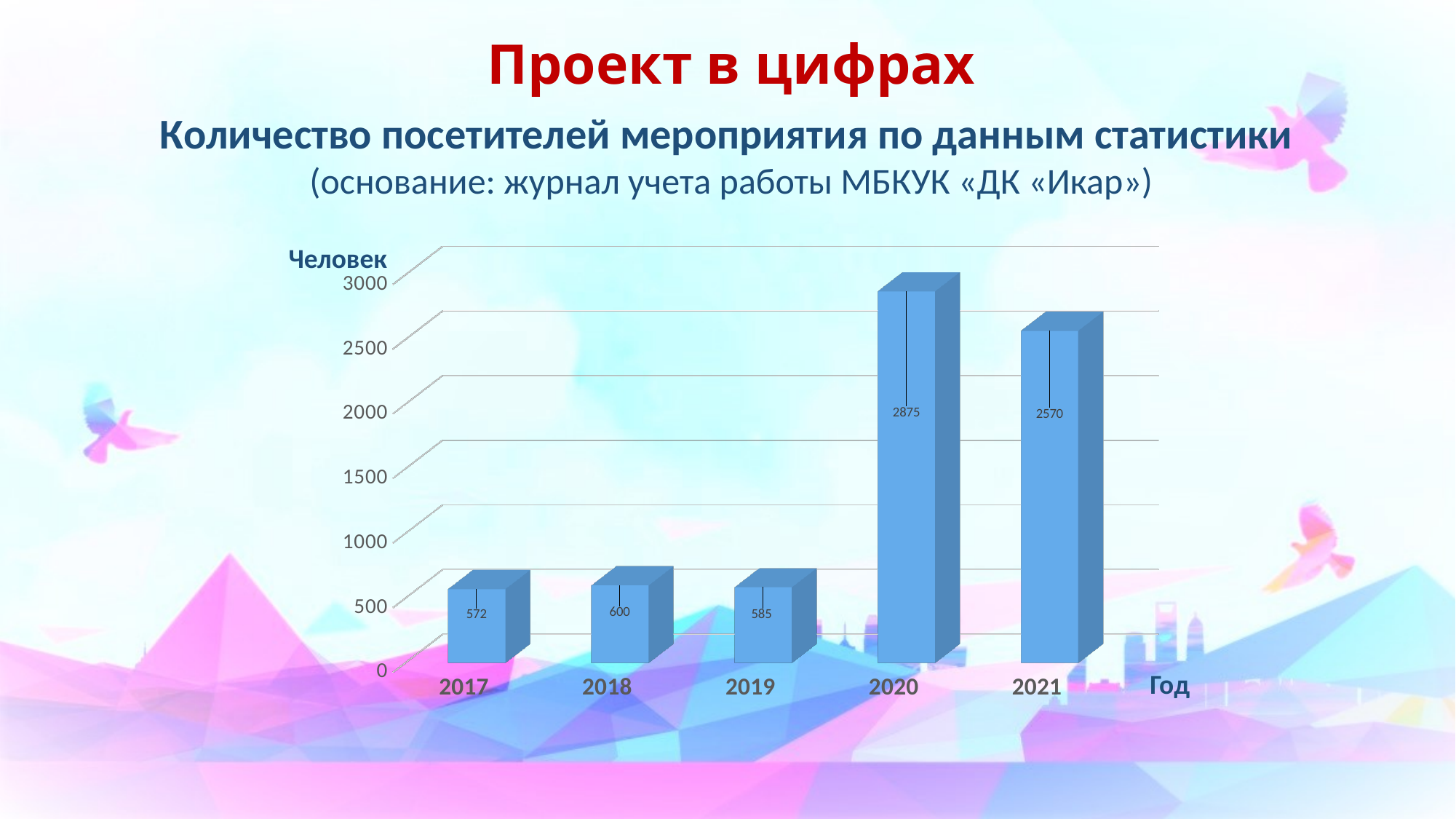
What is the number of visitors shown for 2021? 2570 What is the difference between the visitor counts for 2018 and 2019? 15 What is the difference between the visitor counts for 2020 and 2021? 305 Which year has the highest number of visitors? 2020 Is the value for 2021 greater or less than 2500? greater What is the number of visitors shown for 2017? 572 What is the number of visitors shown for 2020? 2875 Which year has more visitors, 2018 or 2019? 2018 How many years are shown on the x axis? 5 What kind of chart is shown on the slide? bar chart Which year has the lowest number of visitors? 2017 What is the label of the vertical axis? Человек